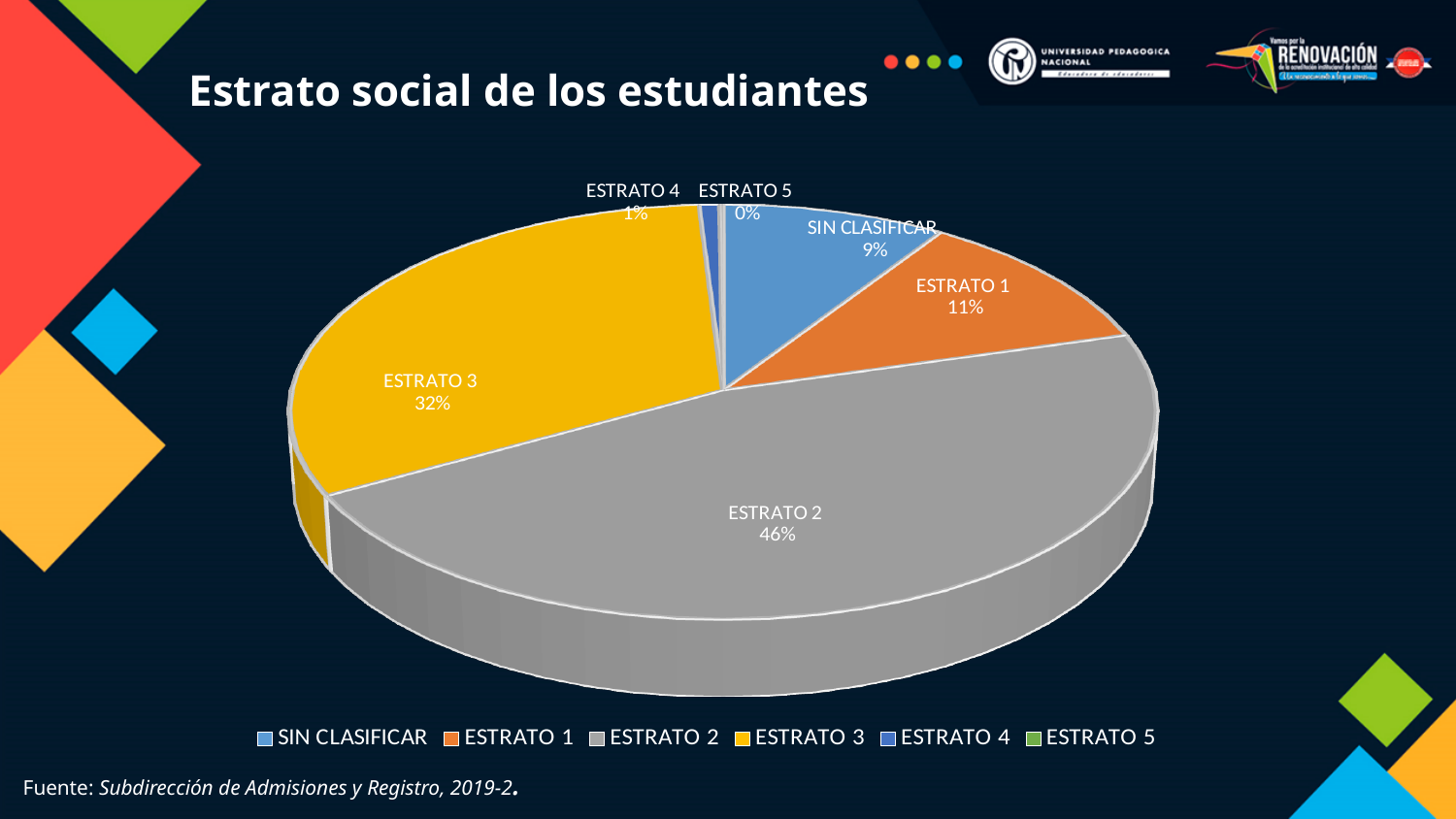
What share of students is in ESTRATO 1? 11% What is the difference in percentage points between ESTRATO 2 and ESTRATO 3? 14 What kind of chart is shown on the slide? Pie chart What share of students is in ESTRATO 4? 1% What percentage of students is labelled SIN CLASIFICAR? 9% What is the title of the chart? Estrato social de los estudiantes Which category has the smallest share of the pie? ESTRATO 5 Which category has the largest share of the pie? ESTRATO 2 Which is larger, the share for ESTRATO 1 or the share for SIN CLASIFICAR? ESTRATO 1 What share of students is in ESTRATO 2? 46% How many categories does the legend list? 6 What share of students is in ESTRATO 3? 32%